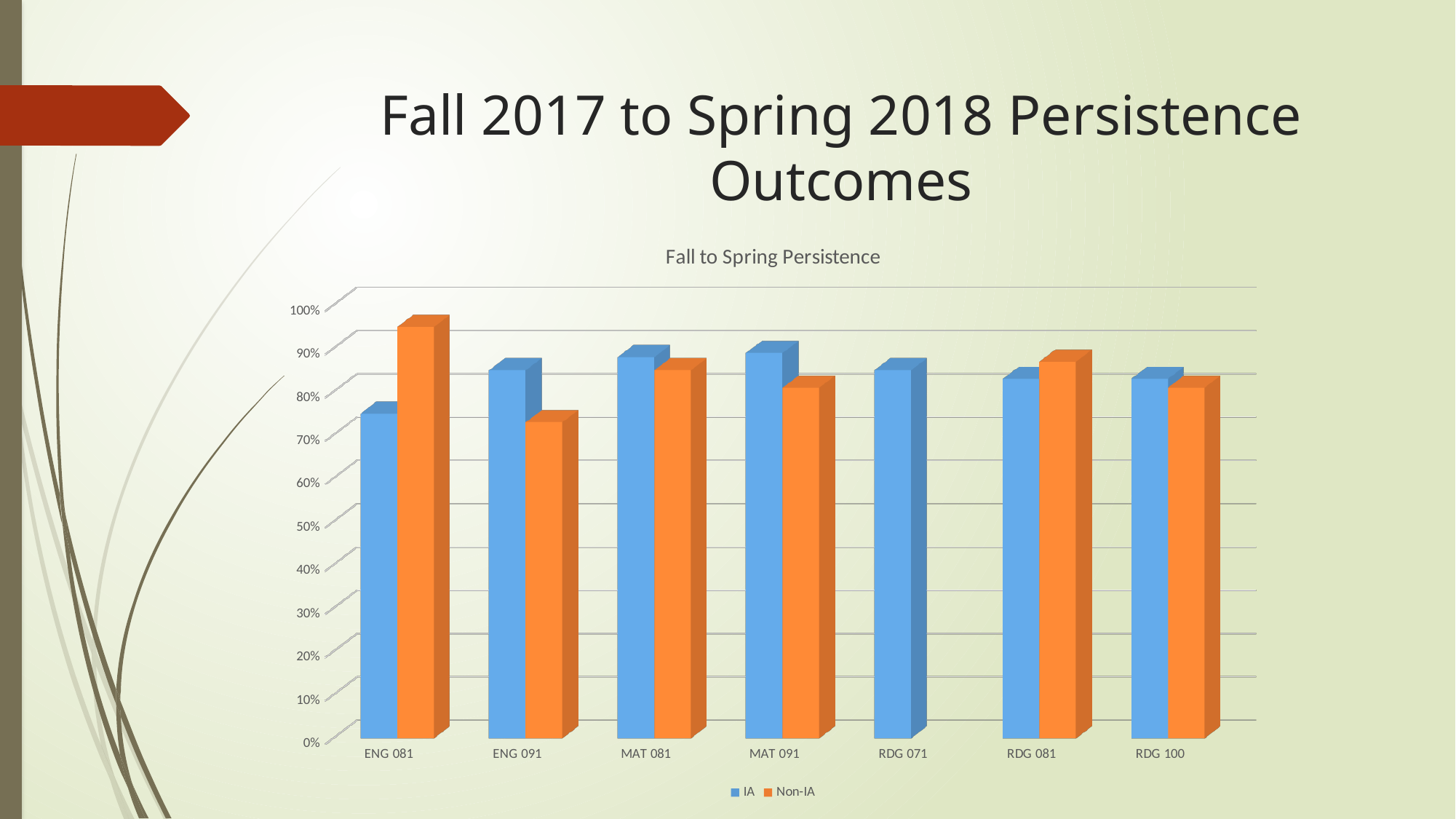
What kind of chart is shown on the slide? bar chart How many course categories are shown on the x axis? 7 Is the Non-IA value for ENG 081 greater or less than 90%? greater Which category has no Non-IA bar? RDG 071 Is the IA value for ENG 081 greater or less than 80%? less For ENG 081, which is larger, the IA value or the Non-IA value? Non-IA How many series does the legend list? 2 What is the title of the chart? Fall to Spring Persistence Which category has the lowest IA value? ENG 081 Is the Non-IA value for ENG 091 greater or less than 80%? less For ENG 091, which is larger, the IA value or the Non-IA value? IA Which category has the highest Non-IA value? ENG 081